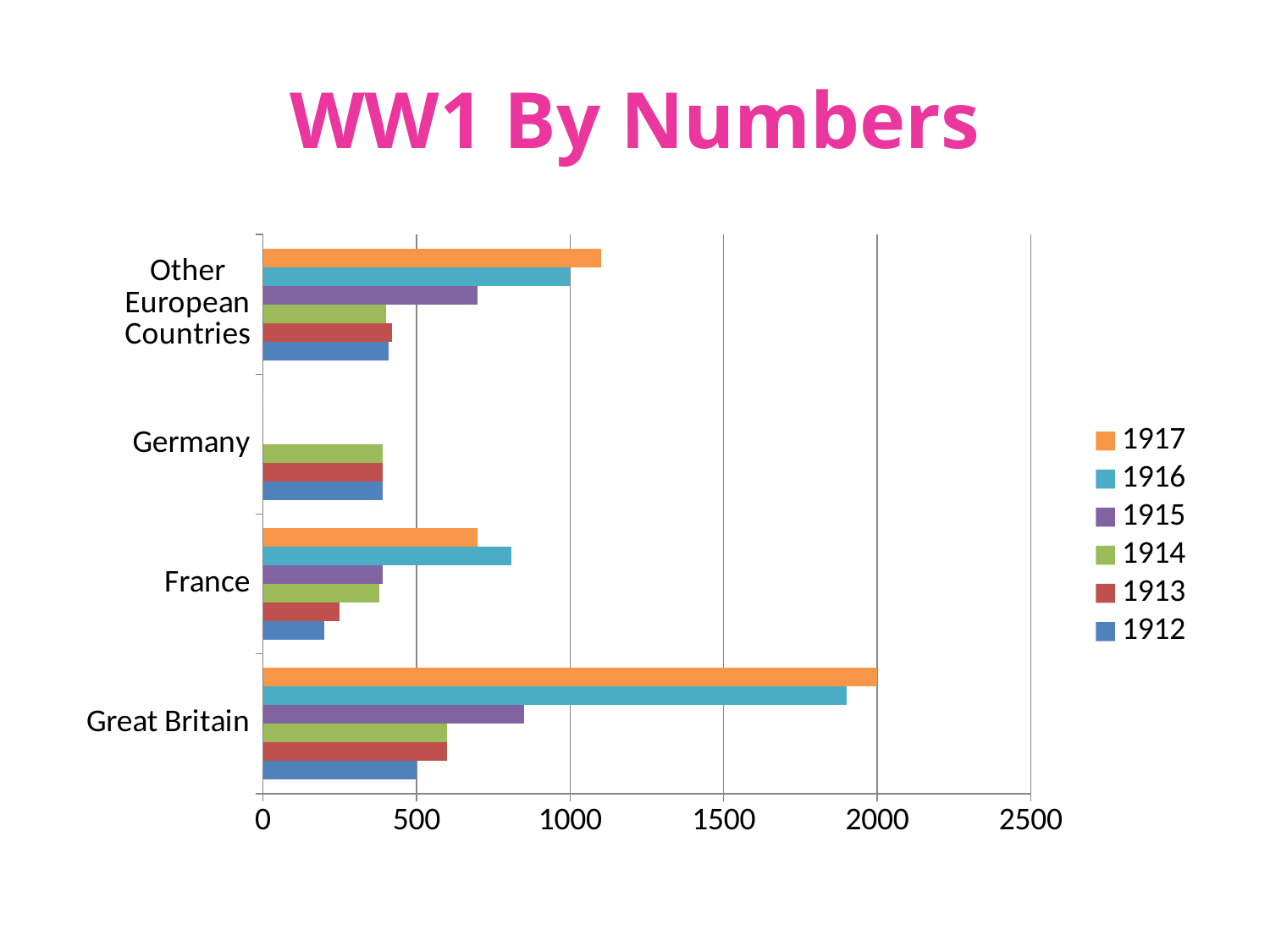
Is the value for Germany in 1914 greater or less than 500? less What is the title of the slide? WW1 By Numbers What is the value for Great Britain in 1917? 2000 Which country has the lowest value for 1912? France What kind of chart is shown on the slide? bar chart Which is larger, the 1916 value for Great Britain or the 1916 value for France? Great Britain How many countries or country groups are listed on the chart? 4 Is the value for France in 1916 greater or less than 500? greater Is the value for Other European Countries in 1917 greater or less than 1000? greater How many series does the legend list? 6 What is the value for Other European Countries in 1916? 1000 Which country has the highest value for 1917? Great Britain